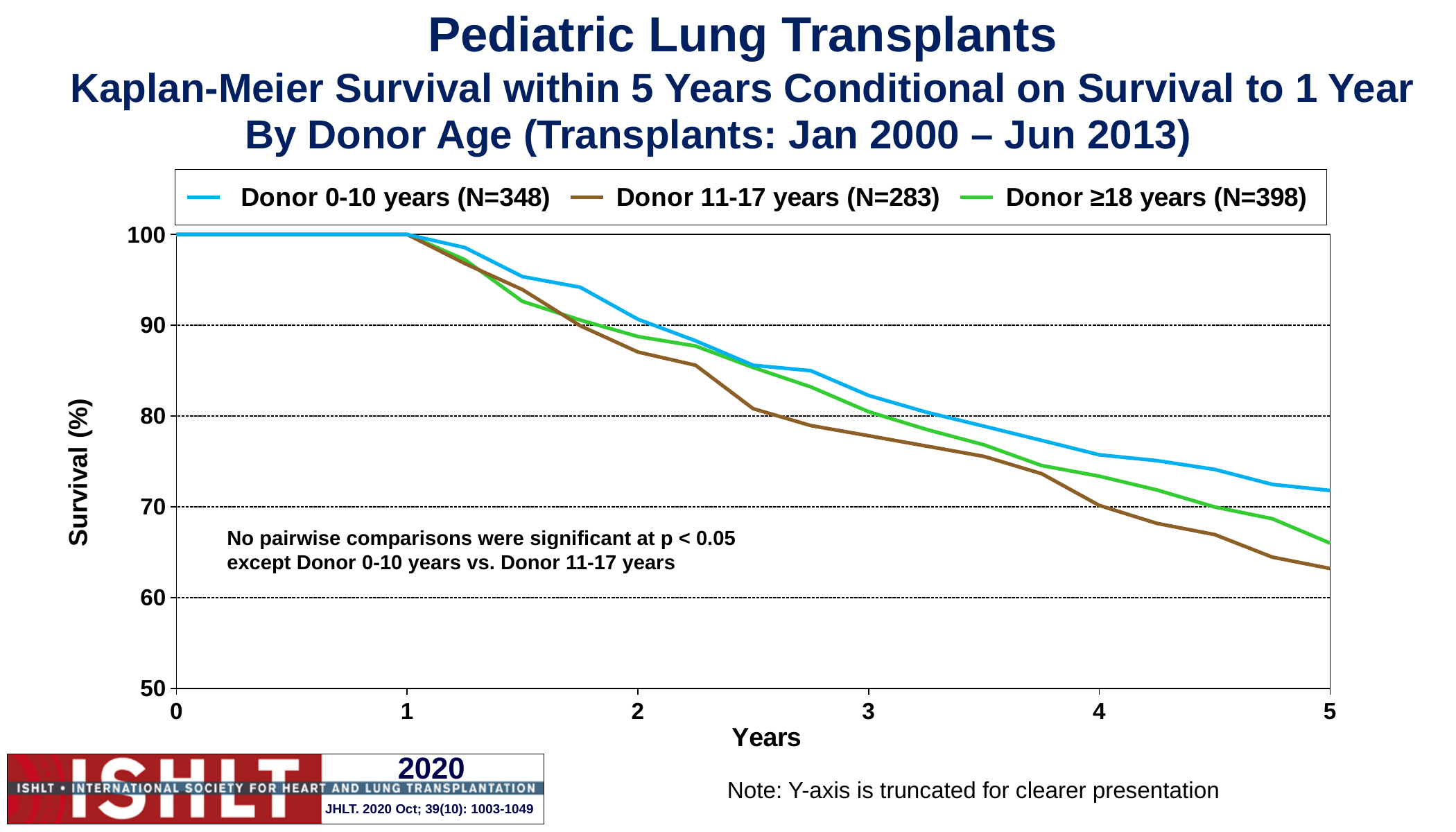
Is the survival for Donor 11-17 years at 5 years greater or less than 70? less Which donor age group has the lowest survival at 5 years? Donor 11-17 years What kind of chart is shown on the slide? line chart What is the survival (%) for Donor 0-10 years at 1 year? 100 Is the survival for Donor 11-17 years at 2 years greater or less than 90? less Which donor age group has the highest survival at 5 years? Donor 0-10 years What is the label of the y axis? Survival (%) At 4 years, which group has higher survival: Donor 0-10 years or Donor 11-17 years? Donor 0-10 years According to the legend, what is the N for the Donor 11-17 years group? 283 How many series does the legend list? 3 What is the survival (%) for Donor ≥18 years at 0 years? 100 Is the survival for Donor 0-10 years at 5 years greater or less than 80? less